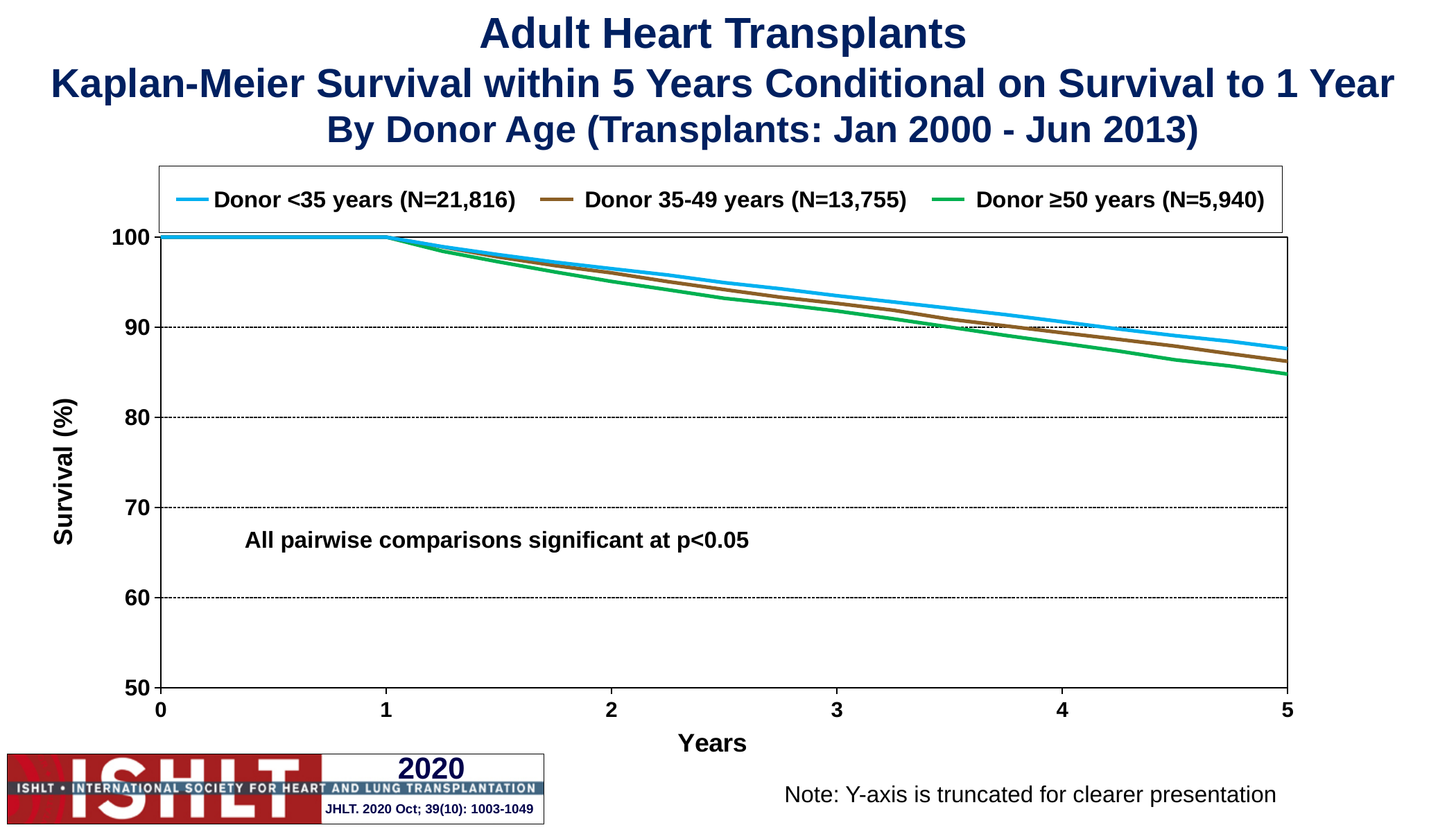
Do the survival curves rise or fall as years increase from 1 to 5? fall Is the survival value for Donor 35-49 years at 5 years greater or less than 80? greater How many series does the legend list? 3 What kind of chart is shown on the slide? line chart What is the label of the y-axis? Survival (%) At 5 years, is survival higher for Donor <35 years or Donor ≥50 years? Donor <35 years Which donor age group has the highest survival at 5 years? Donor <35 years What is the survival value for all three donor age groups at 1 year? 100 Is the survival value for Donor ≥50 years at 5 years greater or less than 90? less What is the N for the Donor <35 years group shown in the legend? N=21,816 Is the survival value for Donor <35 years at 3 years greater or less than 90? greater Which donor age group has the lowest survival at 5 years? Donor ≥50 years